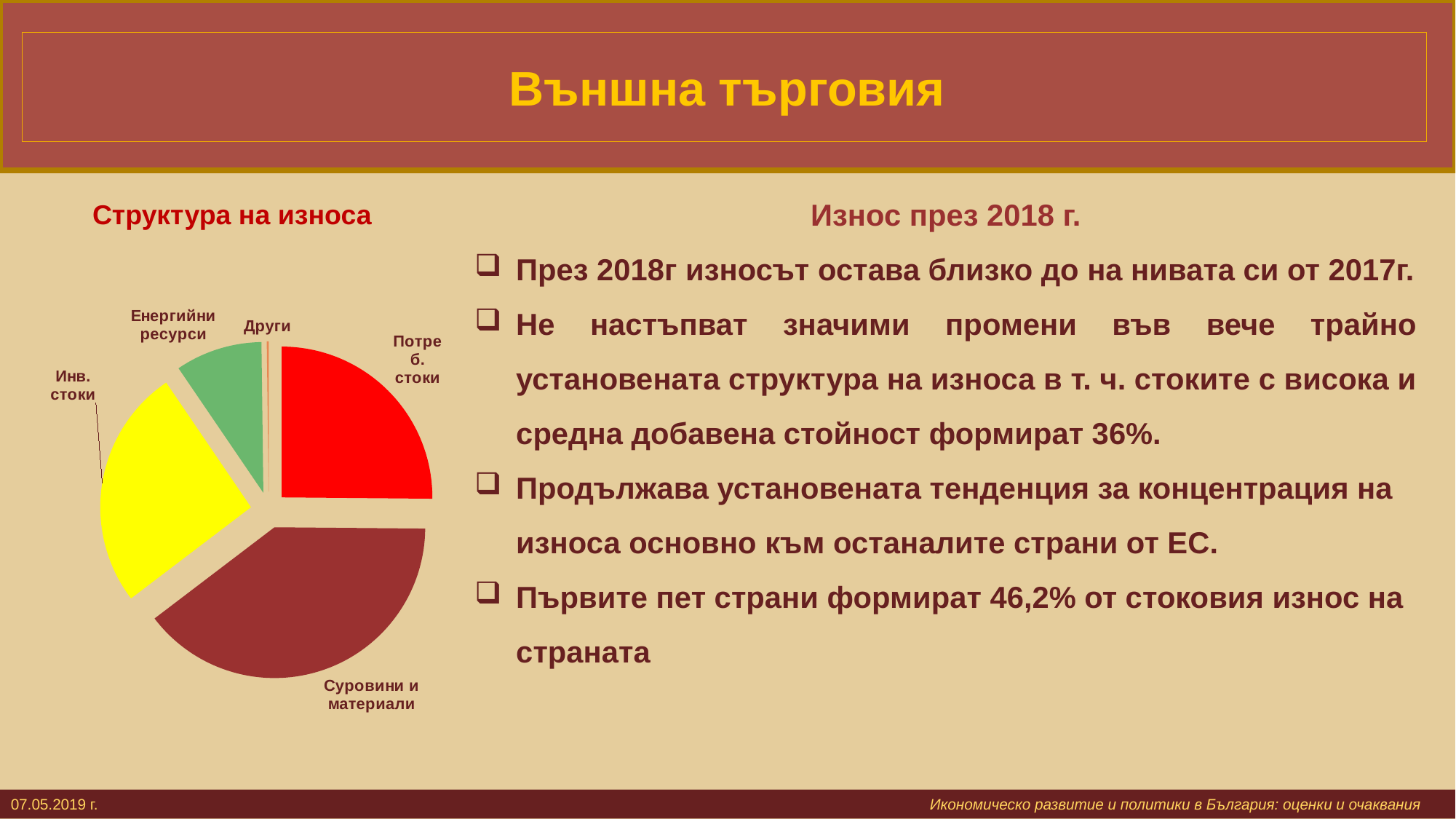
In the pie chart "Структура на износа", which slice is larger: "Потреб. стоки" or "Енергийни ресурси"? Потреб. стоки What kind of chart is shown under the heading "Структура на износа"? pie chart What is the title of the pie chart on the slide? Структура на износа How many slices does the pie chart "Структура на износа" have? 5 In the pie chart "Структура на износа", which slice is larger: "Инв. стоки" or "Енергийни ресурси"? Инв. стоки What colour is the "Инв. стоки" slice in the pie chart "Структура на износа"? yellow Which category has the smallest slice in the pie chart "Структура на износа"? Други Which category has the largest slice in the pie chart "Структура на износа"? Суровини и материали In the pie chart "Структура на износа", which slice is larger: "Енергийни ресурси" or "Други"? Енергийни ресурси